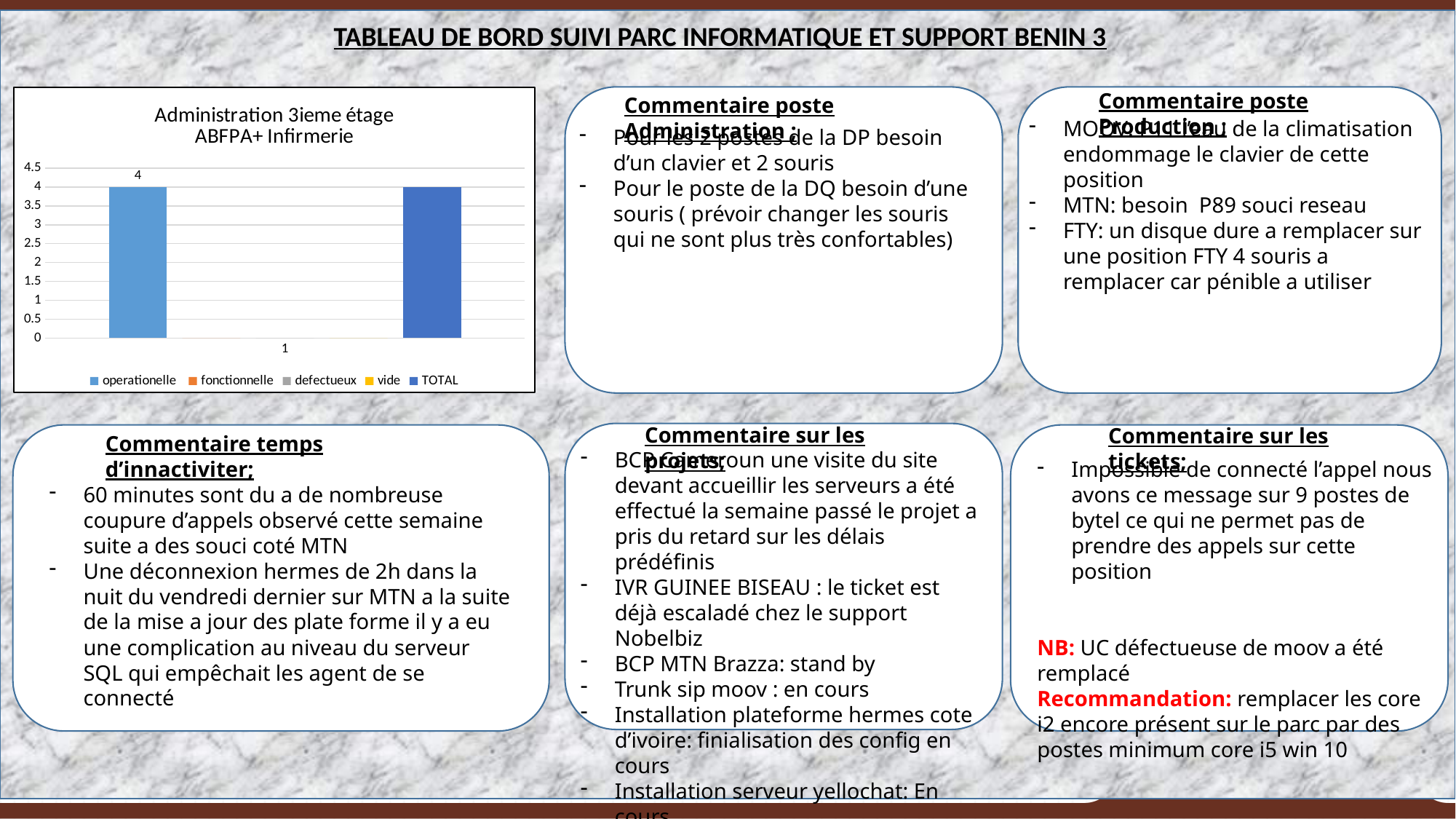
What is the value of the TOTAL bar in the chart? 4 Is the value for operationelle greater or less than 2? greater How many categories are shown on the x axis of the chart? 1 What is the highest value shown on the chart's y axis? 4.5 What kind of chart is shown on the slide? bar chart How many series does the chart legend list? 5 Is the value for TOTAL greater or less than 3? greater Which series is listed first in the chart legend? operationelle What is the value of the operationelle bar in the chart? 4 What is the title of the chart? Administration 3ieme étage ABFPA+ Infirmerie